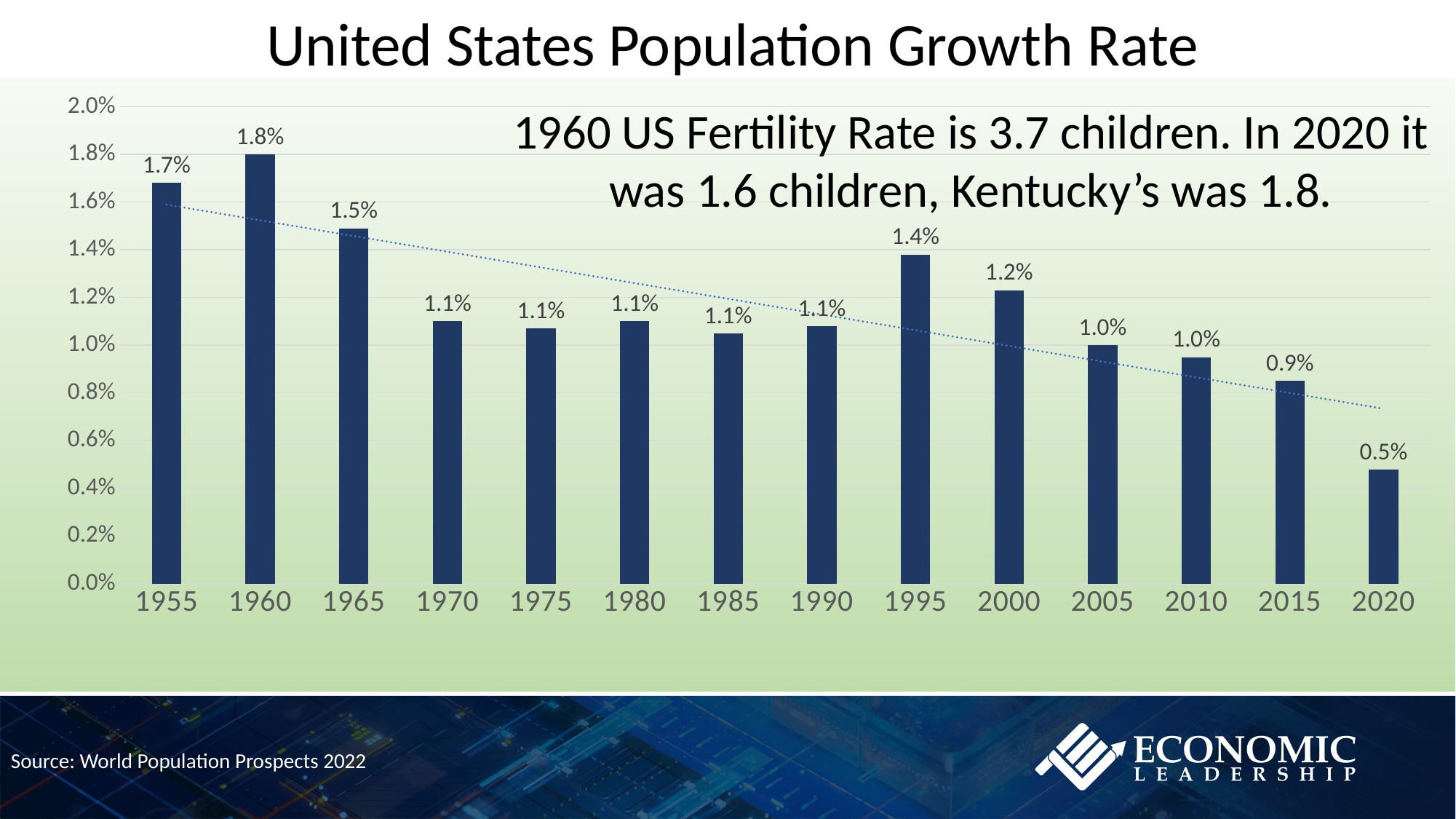
Is the value for 1955 greater or less than 1.6%? greater What is the population growth rate shown for 1960? 1.8% What is the difference between the growth rate in 1960 and the growth rate in 2020? 1.3% Which year has a higher growth rate, 1995 or 2000? 1995 How many years are shown on the x axis of the chart? 14 What source is cited for the chart data? World Population Prospects 2022 What is the population growth rate shown for 2020? 0.5% What kind of chart is used to show the population growth rate? Bar chart Overall, do the growth rate values rise or fall from 1955 to 2020? Fall Which year has the lowest population growth rate? 2020 What is the population growth rate shown for 1995? 1.4% Which year has the highest population growth rate? 1960